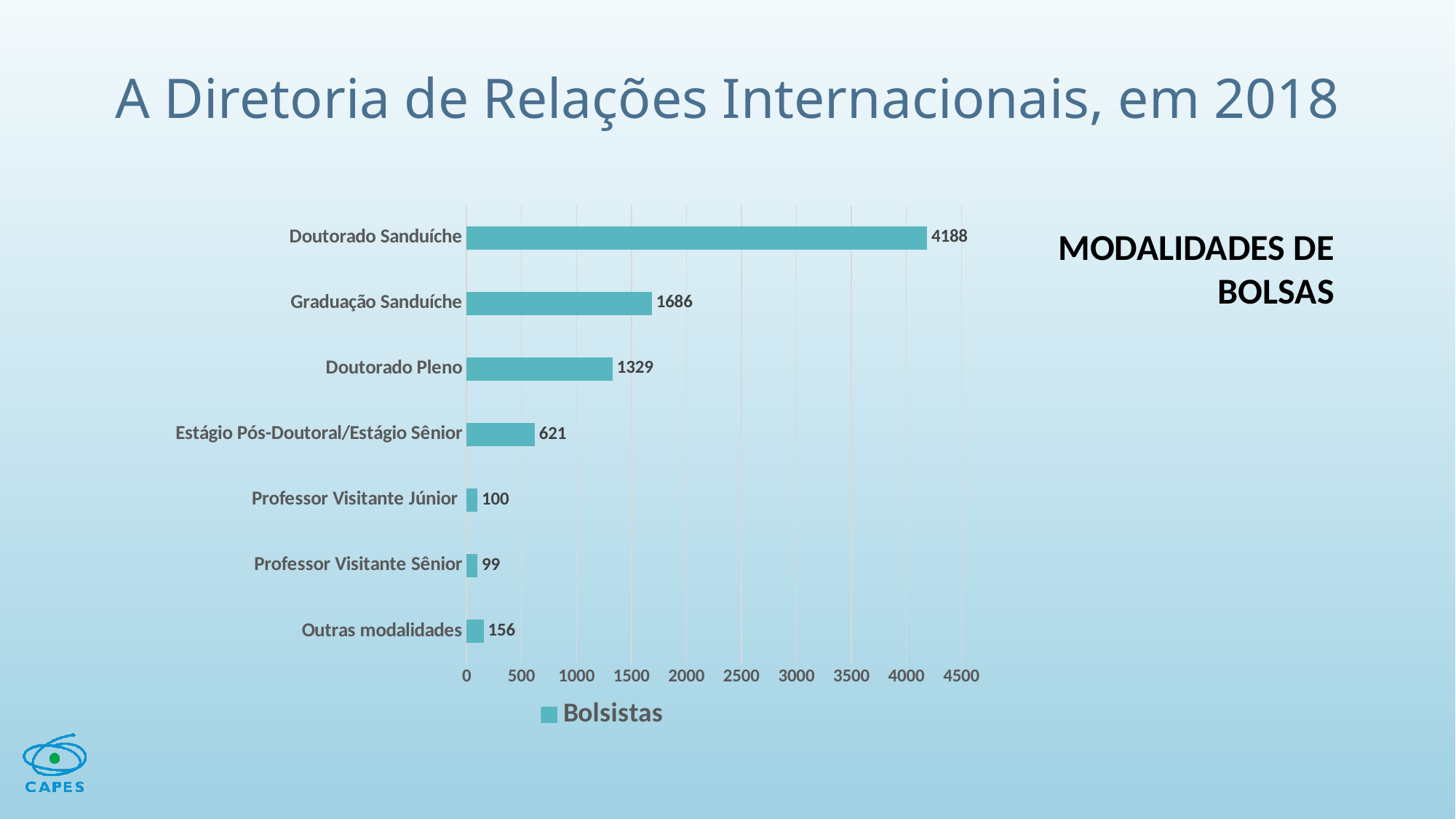
Which is larger, Doutorado Pleno or Estágio Pós-Doutoral/Estágio Sênior? Doutorado Pleno Is the value for Doutorado Pleno greater or less than 1000? greater What is the value for Doutorado Sanduíche? 4188 What is the difference between Doutorado Sanduíche and Graduação Sanduíche? 2502 What is the value for Estágio Pós-Doutoral/Estágio Sênior? 621 How many categories are shown in the chart? 7 Which category has the lowest value? Professor Visitante Sênior What is the value for Graduação Sanduíche? 1686 What kind of chart is shown on the slide? bar chart Which category has the highest value? Doutorado Sanduíche What is the value for Outras modalidades? 156 What series name does the legend show? Bolsistas